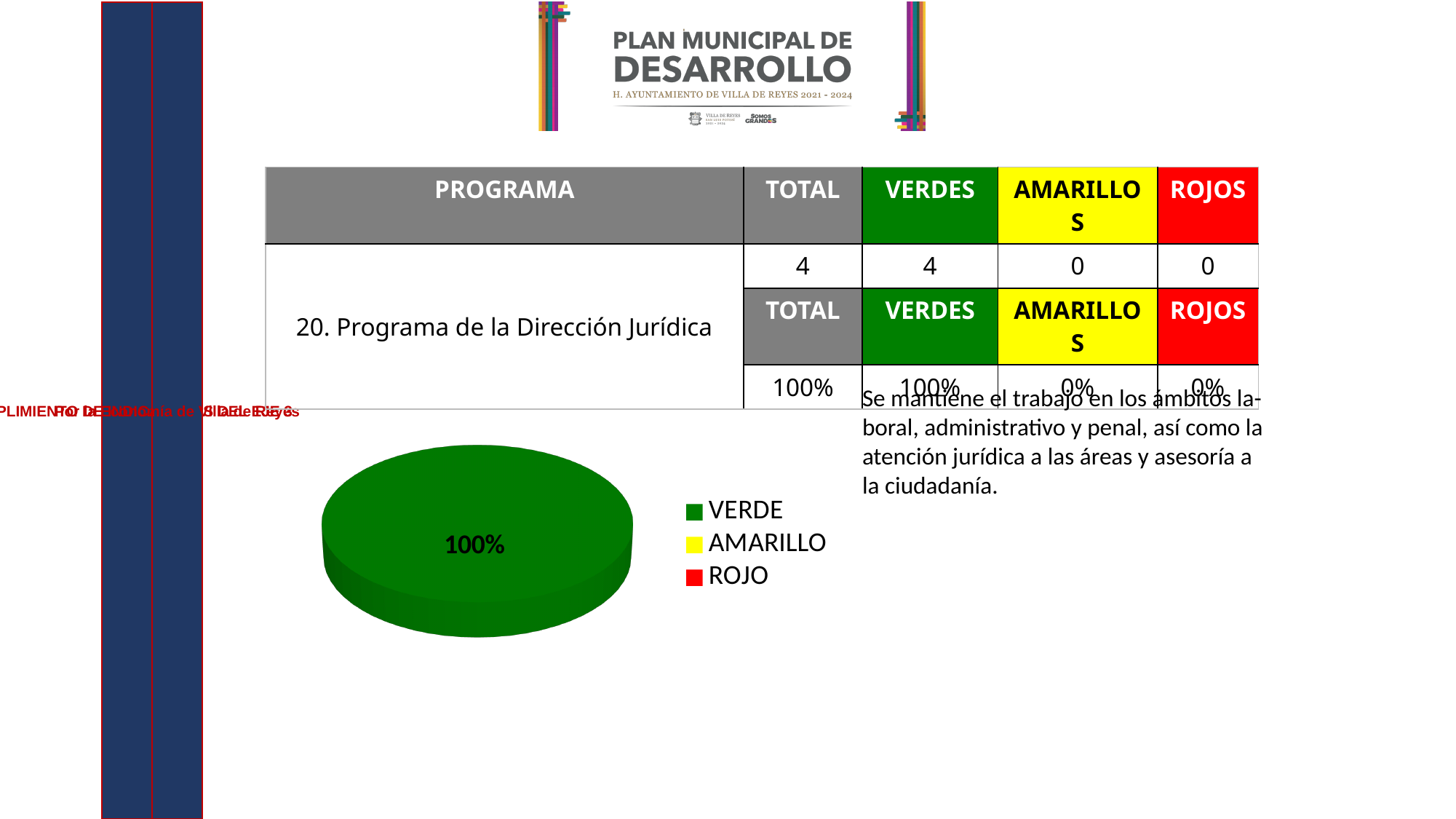
What colour represents ROJO in the pie chart's legend? red Which is larger in the pie chart, the share for VERDE or the share for ROJO? VERDE How many entries does the pie chart's legend list? 3 Which category has the largest share of the pie chart? VERDE What colour represents VERDE in the pie chart's legend? green What kind of chart is shown on the slide? pie chart What percentage is printed on the pie chart's slice? 100% What share of the pie does VERDE take? 100% Which is larger in the pie chart, the share for VERDE or the share for AMARILLO? VERDE How many slices are visible in the pie chart? 1